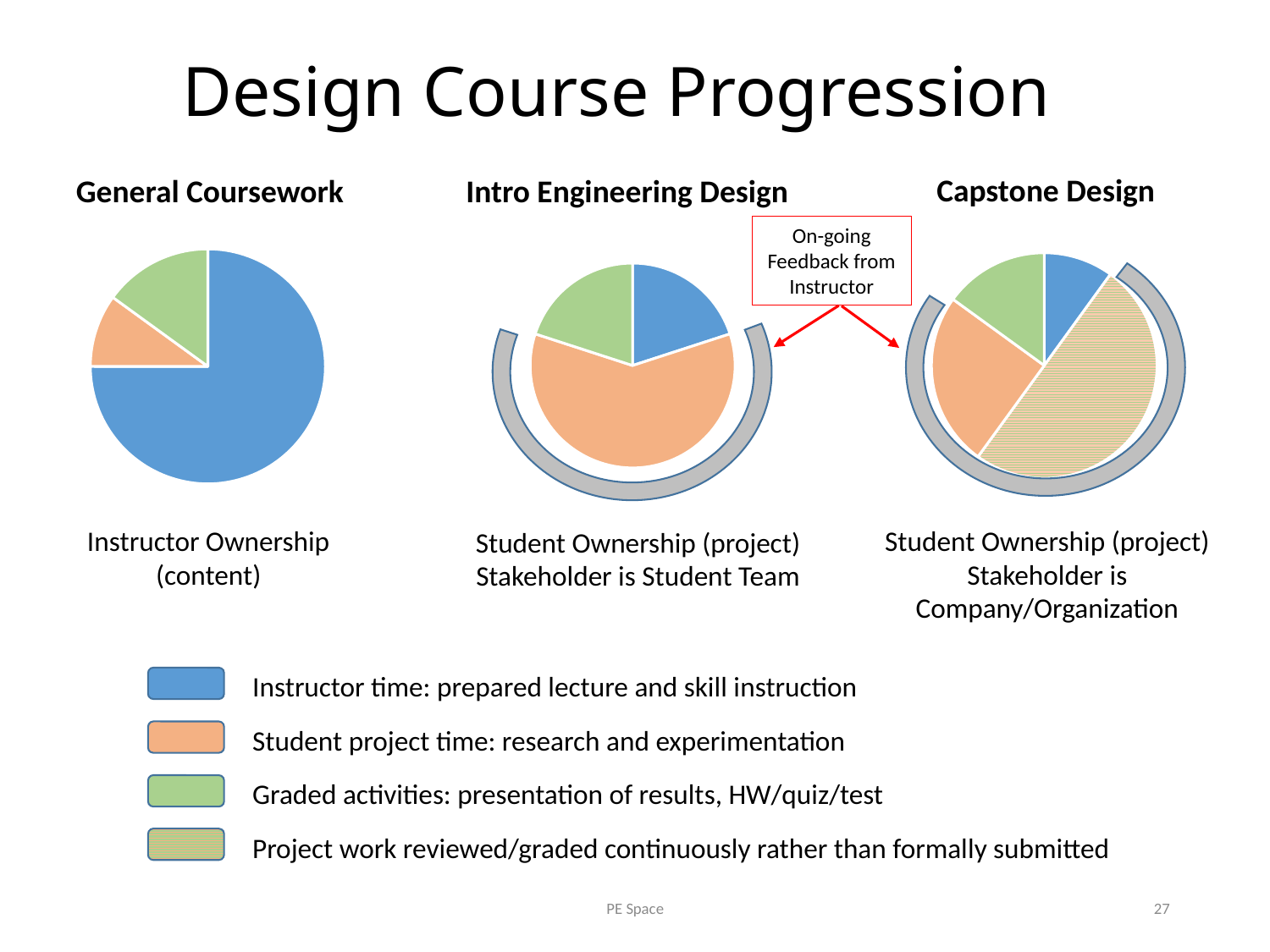
How many entries does the legend at the bottom of the slide list? 4 In the Intro Engineering Design pie chart, which category takes the largest share? Student project time: research and experimentation What kind of chart is used for General Coursework? Pie chart In the Capstone Design pie chart, which category takes the largest share? Project work reviewed/graded continuously rather than formally submitted What does the callout box with red arrows pointing to the Intro Engineering Design and Capstone Design charts say? On-going Feedback from Instructor What is the title of the slide containing the three pie charts? Design Course Progression In the Intro Engineering Design pie chart, which is larger: the Student project time slice or the Graded activities slice? Student project time How many slices does the General Coursework pie chart have? 3 In the Capstone Design pie chart, which category takes the smallest share? Instructor time: prepared lecture and skill instruction How many slices does the Capstone Design pie chart have? 4 In the General Coursework pie chart, which is larger: the Instructor time slice or the Student project time slice? Instructor time In the General Coursework pie chart, which category takes the largest share? Instructor time: prepared lecture and skill instruction